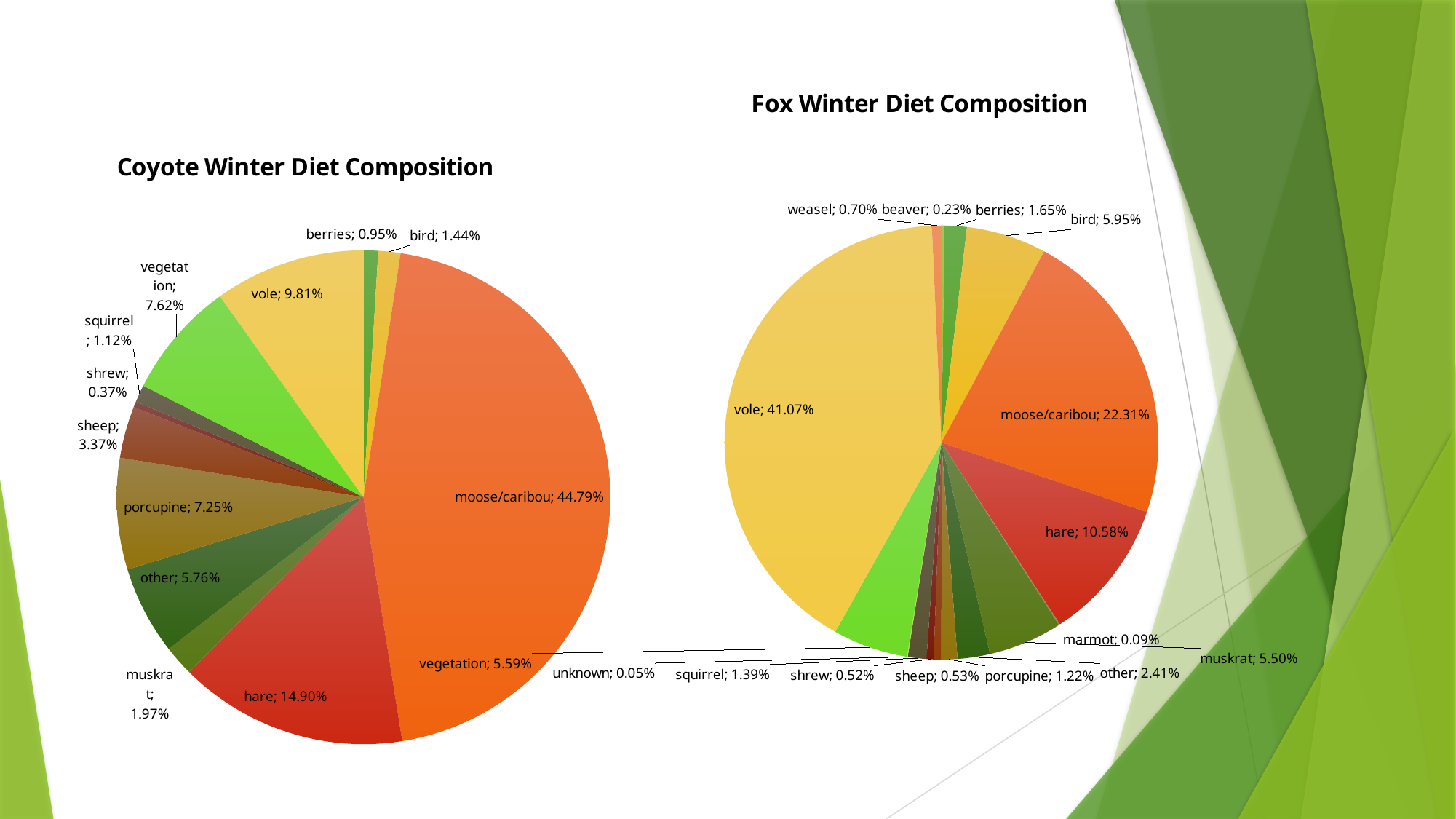
In the Coyote Winter Diet Composition chart, what share does porcupine make up? 7.25% In the Fox Winter Diet Composition chart, which category has the largest slice? vole In the Fox Winter Diet Composition chart, what share does bird make up? 5.95% What type of chart is used for the Fox Winter Diet Composition? pie chart In the Coyote Winter Diet Composition chart, which category has the smallest share? shrew In the Coyote Winter Diet Composition chart, what is the difference between the hare share and the vole share? 5.09% Which is larger: the hare share in the Coyote chart or the hare share in the Fox chart? Coyote In the Coyote Winter Diet Composition chart, what share does moose/caribou make up? 44.79% In the Fox Winter Diet Composition chart, which category has the smallest share? unknown In the Fox Winter Diet Composition chart, what share does vole make up? 41.07% In the Fox Winter Diet Composition chart, what is the difference between the moose/caribou share and the hare share? 11.73% In the Coyote Winter Diet Composition chart, which category has the largest slice? moose/caribou